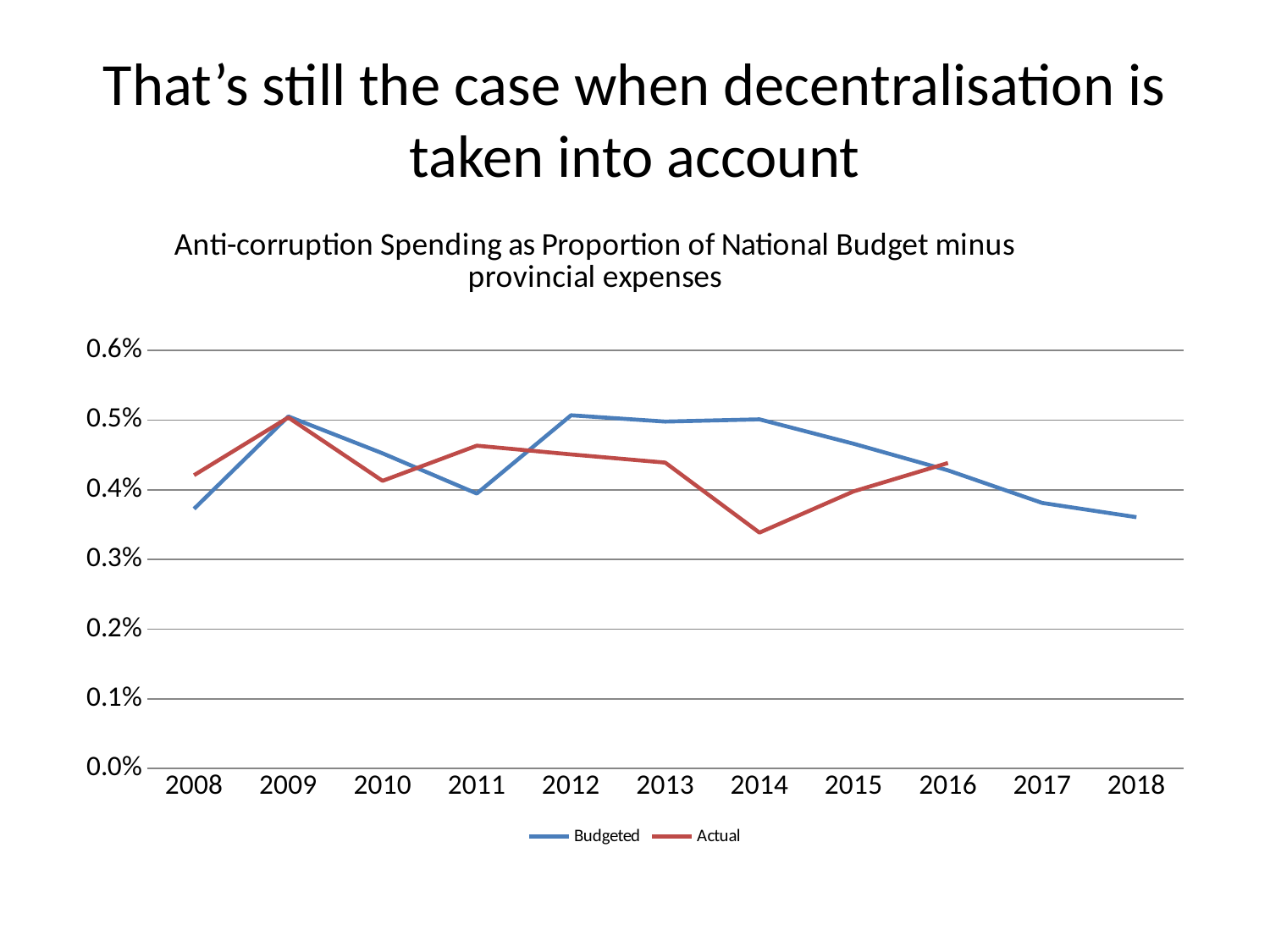
What is the title of the chart? Anti-corruption Spending as Proportion of National Budget minus provincial expenses How many series does the legend list? 2 Is the Actual value for 2014 greater or less than 0.4%? less How many years are shown on the x axis? 11 Does the Budgeted line rise or fall from 2014 to 2018? Fall Is the Budgeted value for 2008 greater or less than 0.4%? less In which year is the Actual value highest? 2009 In 2014, which is larger, the Budgeted value or the Actual value? Budgeted Which series does the red line represent? Actual What kind of chart is shown on the slide? Line chart In which year is the Actual value lowest? 2014